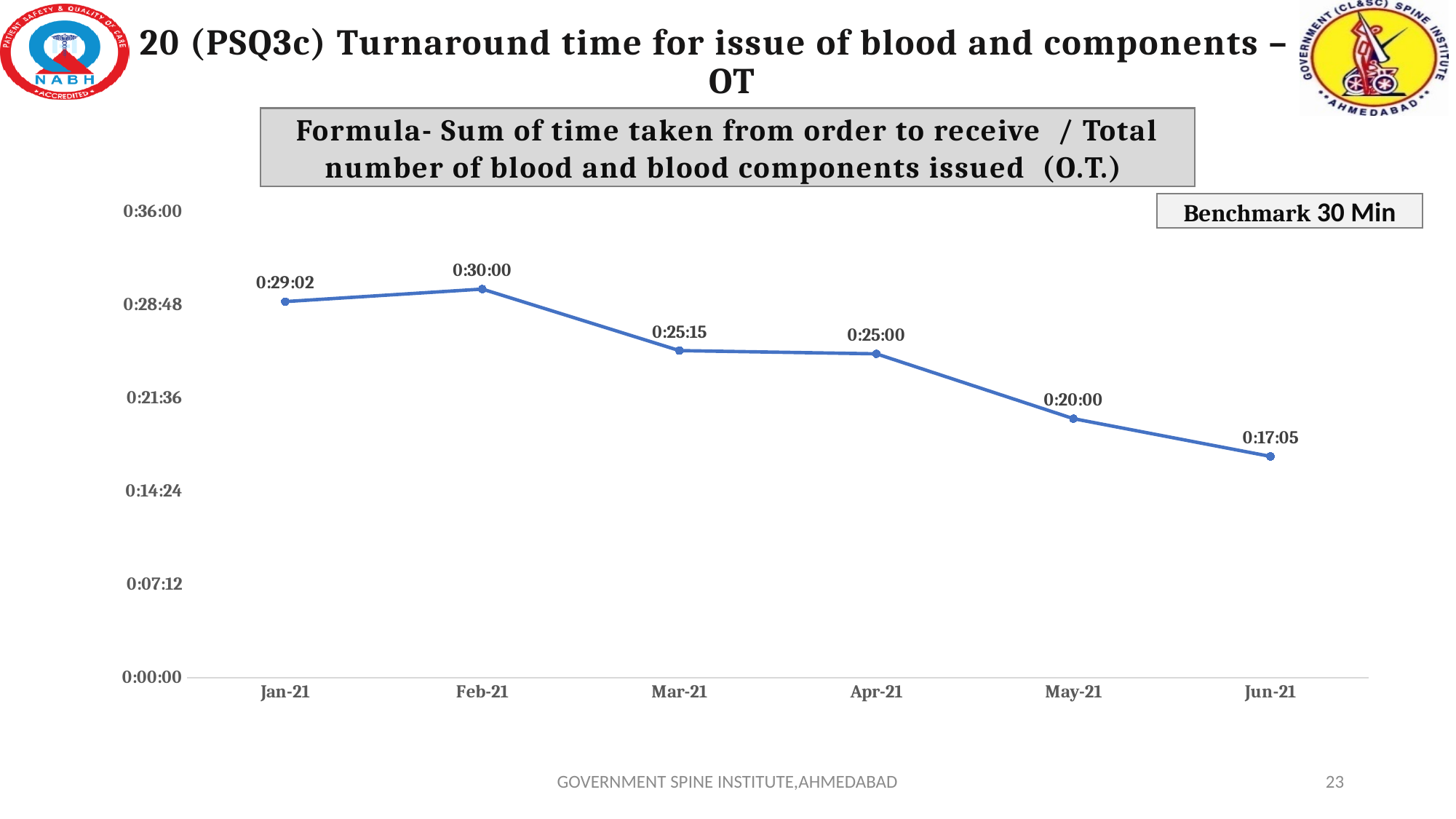
Which month has the highest turnaround time? Feb-21 What is the difference between the turnaround times for Apr-21 and May-21? 0:05:00 What is the turnaround time for Mar-21? 0:25:15 Which month has the lowest turnaround time? Jun-21 Do the turnaround times generally rise or fall from Feb-21 to Jun-21? Fall What is the turnaround time for Jan-21? 0:29:02 What benchmark is stated on the slide? 30 Min What is the turnaround time for Jun-21? 0:17:05 Which is larger, the turnaround time for Jan-21 or for Mar-21? Jan-21 What kind of chart is shown on the slide? Line chart What is the turnaround time for Feb-21? 0:30:00 How many months are plotted on the chart? 6